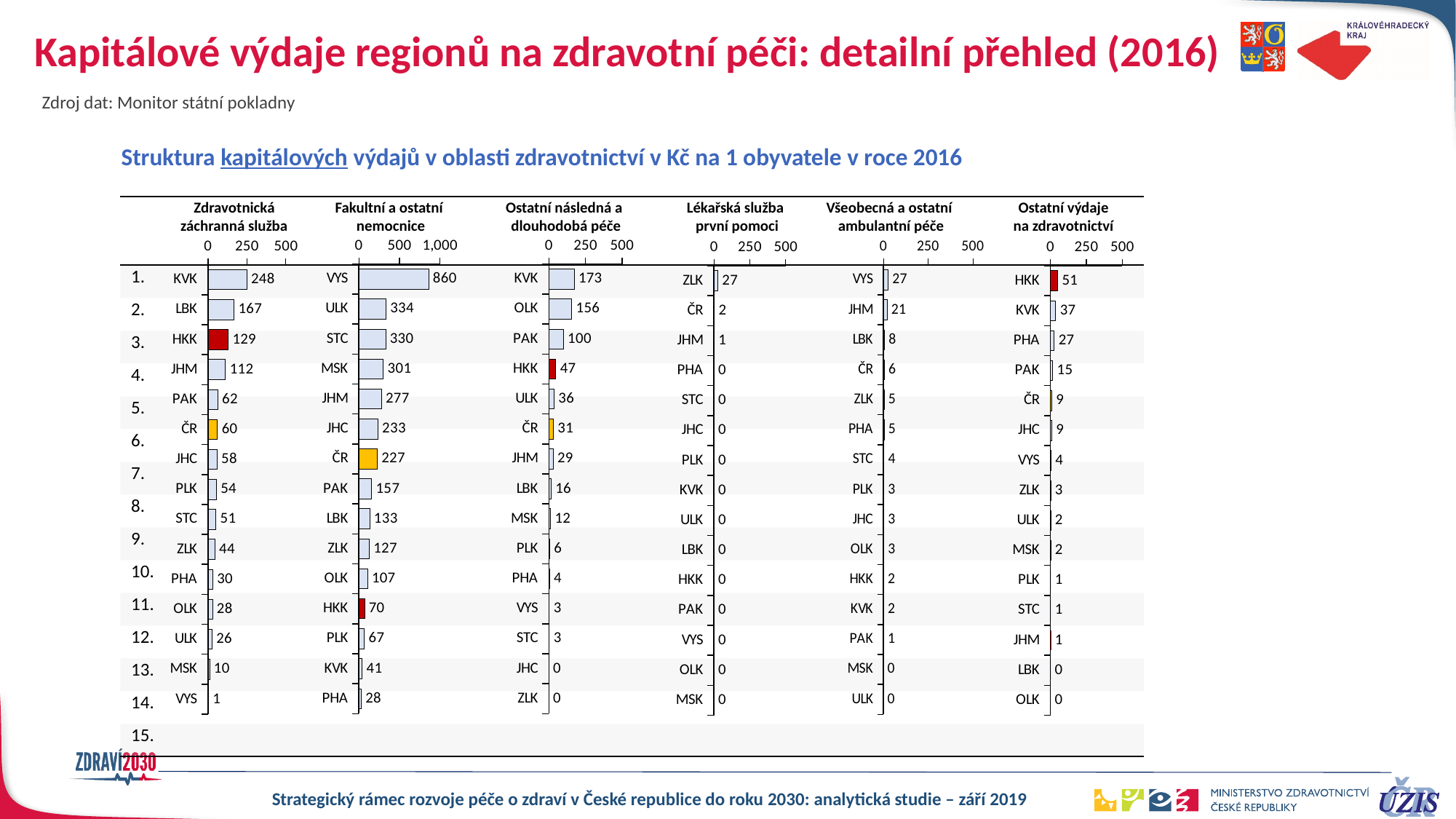
In the 'Všeobecná a ostatní ambulantní péče' chart, what is the value for JHM? 21 In the 'Zdravotnická záchranná služba' chart, which region has the lowest value? VYS In the 'Ostatní výdaje na zdravotnictví' chart, which is larger, HKK or KVK? HKK In the 'Zdravotnická záchranná služba' chart, what is the value for KVK? 248 In the 'Ostatní následná a dlouhodobá péče' chart, what is the difference between KVK and OLK? 17 How many regions (including ČR) are listed in the 'Fakultní a ostatní nemocnice' chart? 15 In the 'Fakultní a ostatní nemocnice' chart, what is the value for HKK? 70 What kind of chart is used for 'Ostatní následná a dlouhodobá péče'? Bar chart In the 'Lékařská služba první pomoci' chart, which region has the highest value? ZLK In the 'Fakultní a ostatní nemocnice' chart, is the value for VYS greater or less than 500? greater In the 'Zdravotnická záchranná služba' chart, what is the difference between LBK and HKK? 38 In the 'Fakultní a ostatní nemocnice' chart, which region has the highest value? VYS